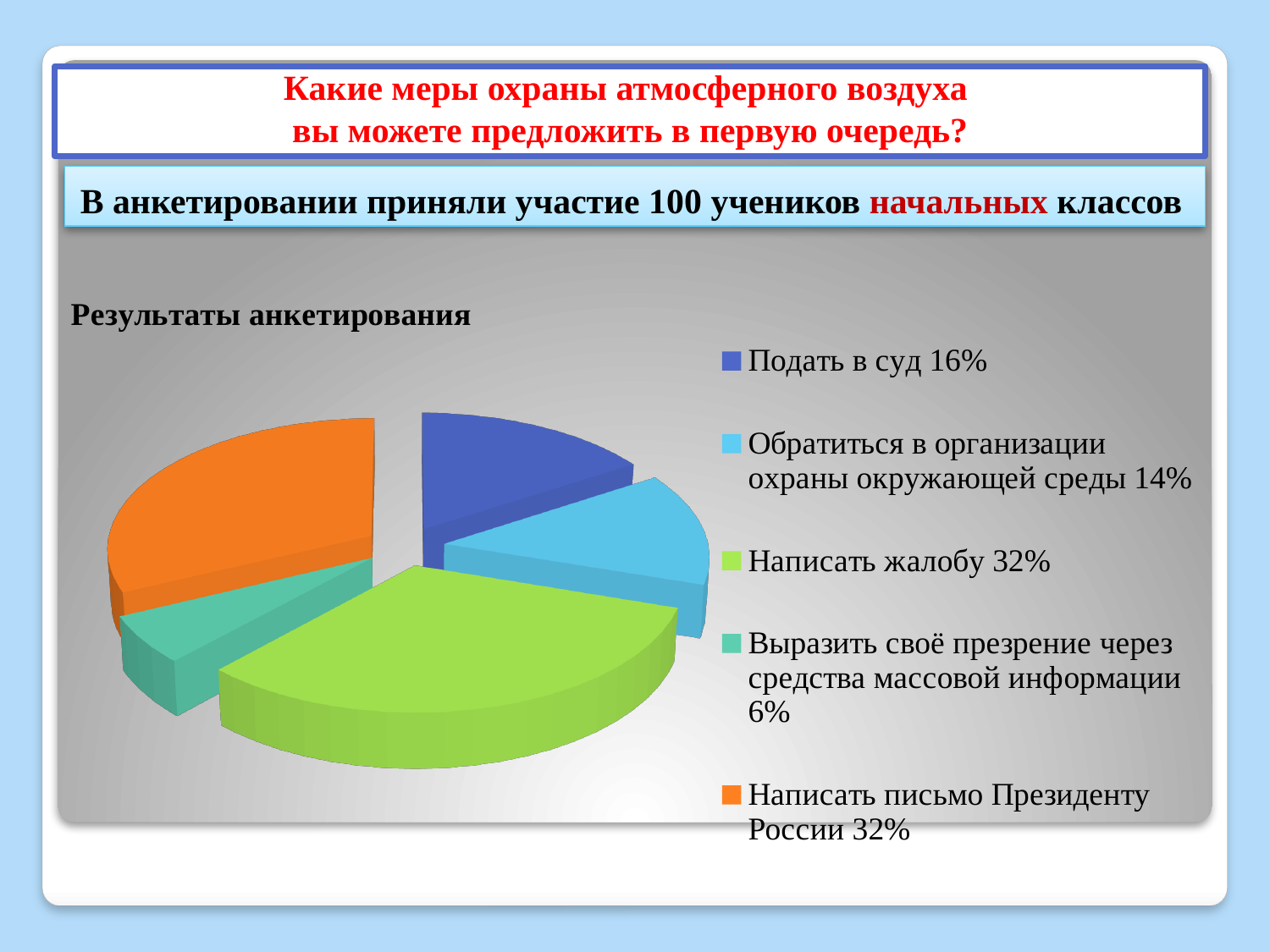
What share of respondents chose "Выразить своё презрение через средства массовой информации"? 6% What share of respondents chose "Обратиться в организации охраны окружающей среды"? 14% What is the difference in percentage points between "Написать жалобу" and "Подать в суд"? 16 What is the chart's title? Результаты анкетирования How many categories does the pie chart have? 5 What kind of chart is shown on the slide? Pie chart What colour is the slice for "Написать письмо Президенту России"? Orange What share of respondents chose "Подать в суд"? 16% What share of respondents chose "Написать письмо Президенту России"? 32% Which is larger: the share for "Подать в суд" or the share for "Обратиться в организации охраны окружающей среды"? Подать в суд Which category has the smallest share of the pie? Выразить своё презрение через средства массовой информации What share of respondents chose "Написать жалобу"? 32%